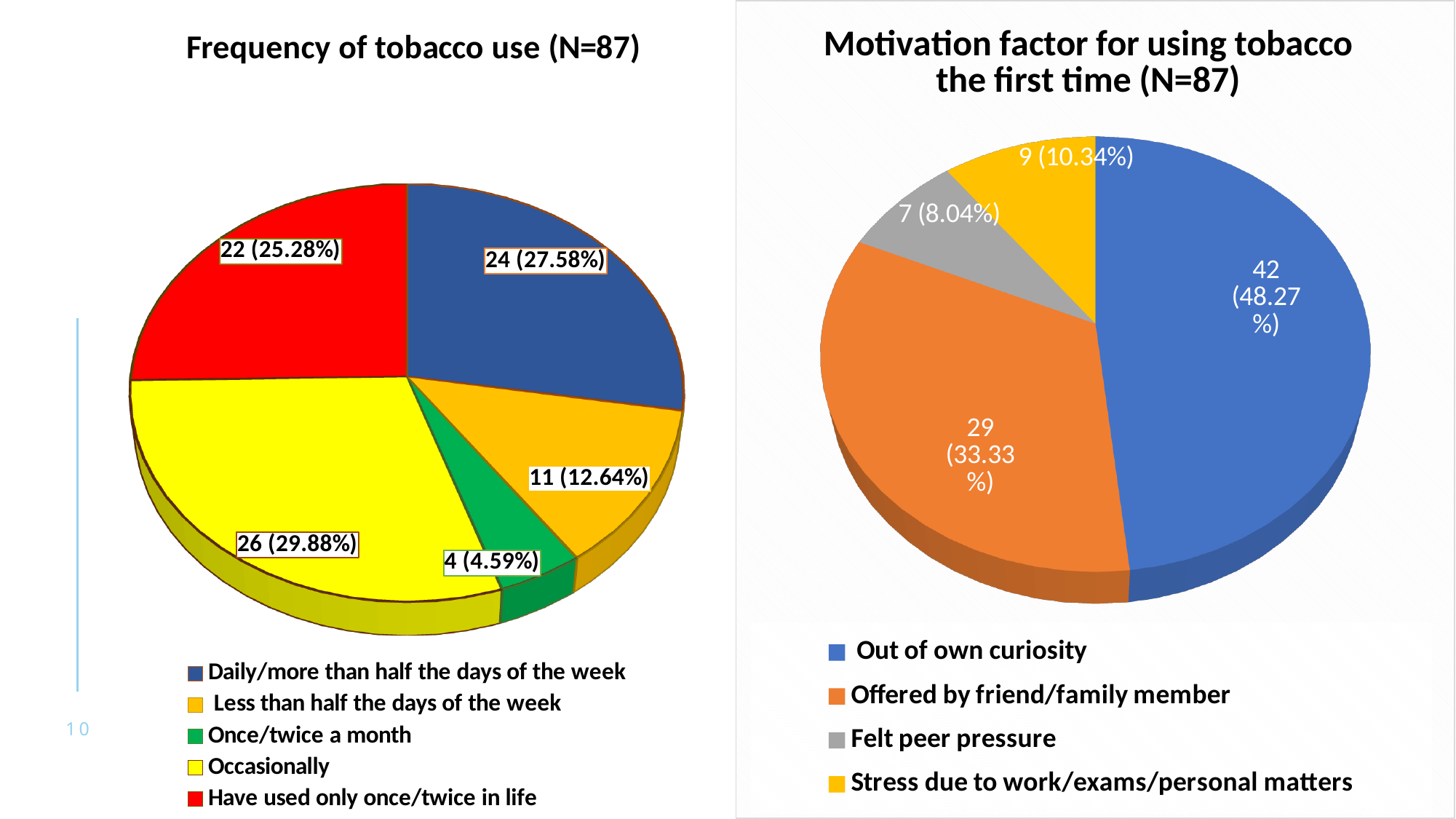
In the 'Frequency of tobacco use (N=87)' chart, what is the value for 'Once/twice a month'? 4 (4.59%) In the 'Motivation factor for using tobacco the first time (N=87)' chart, which category has the largest slice? Out of own curiosity In the 'Frequency of tobacco use (N=87)' chart, which category has the smallest slice? Once/twice a month In the 'Frequency of tobacco use (N=87)' chart, what is the difference in count between 'Daily/more than half the days of the week' and 'Less than half the days of the week'? 13 In the 'Frequency of tobacco use (N=87)' chart, which category has the largest slice? Occasionally What type of chart is used on the right side of the slide? Pie chart In the 'Motivation factor for using tobacco the first time (N=87)' chart, what is the difference in count between 'Out of own curiosity' and 'Offered by friend/family member'? 13 In the 'Frequency of tobacco use (N=87)' chart, how many categories are shown? 5 In the 'Motivation factor for using tobacco the first time (N=87)' chart, what share of the pie is 'Out of own curiosity'? 48.27% In the 'Frequency of tobacco use (N=87)' chart, what is the value for 'Occasionally'? 26 (29.88%) In the 'Motivation factor for using tobacco the first time (N=87)' chart, what is the value for 'Felt peer pressure'? 7 (8.04%) In the 'Motivation factor for using tobacco the first time (N=87)' chart, which is larger: 'Felt peer pressure' or 'Stress due to work/exams/personal matters'? Stress due to work/exams/personal matters